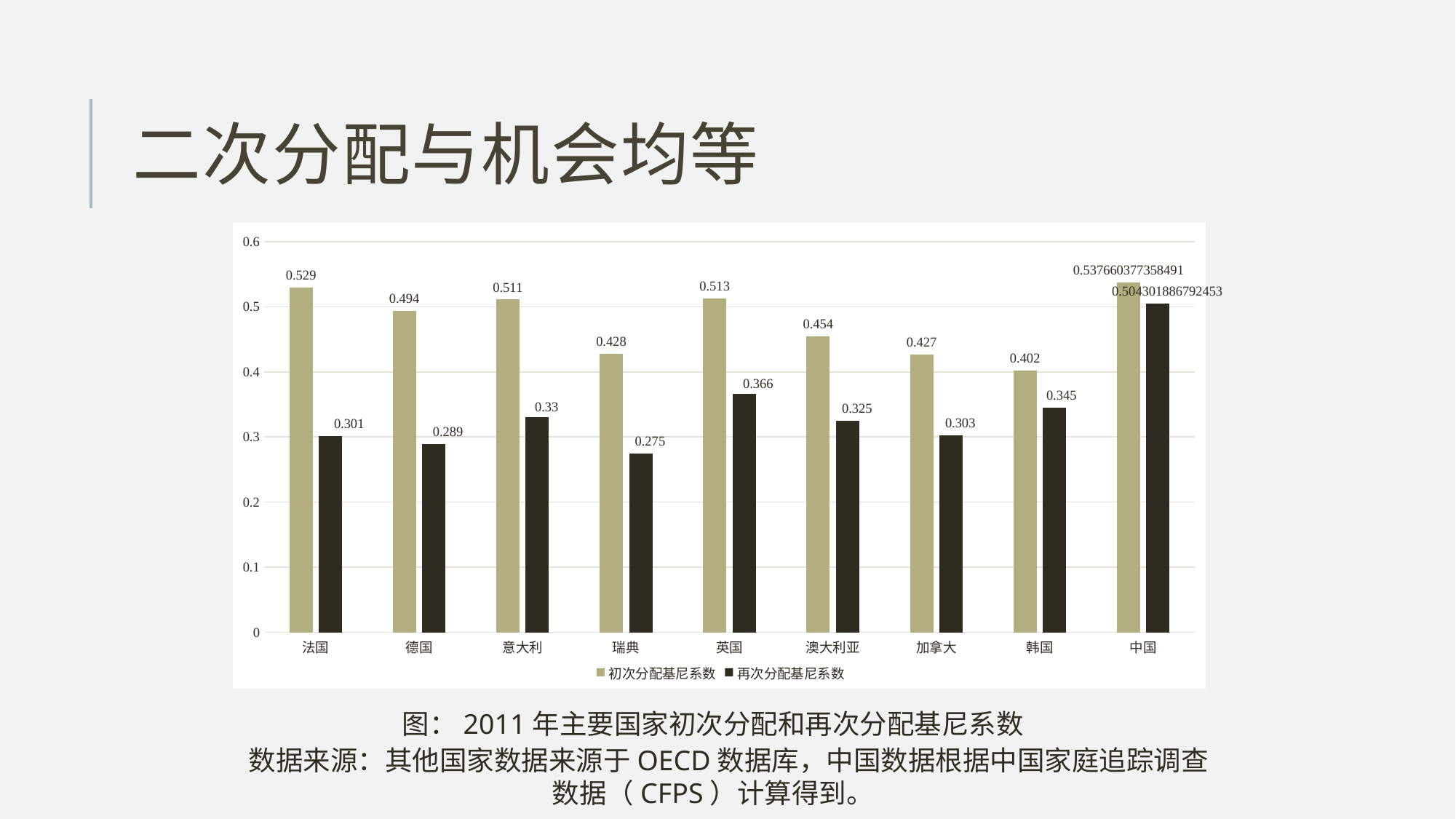
What is the 再次分配基尼系数 value for 英国? 0.366 What kind of chart is shown on the slide? bar chart Which country has the lowest 再次分配基尼系数? 瑞典 What are the two series named in the legend? 初次分配基尼系数 and 再次分配基尼系数 What is the 初次分配基尼系数 value for 法国? 0.529 How many countries are shown on the x axis? 9 Is the 再次分配基尼系数 for 澳大利亚 greater or less than 0.3? greater Which is larger, the 初次分配基尼系数 for 德国 or for 瑞典? 德国 Which country has the highest 初次分配基尼系数? 中国 What is the 再次分配基尼系数 value for 中国? 0.504301886792453 How many series does the legend list? 2 What is the difference between the 初次分配基尼系数 and 再次分配基尼系数 for 法国? 0.228